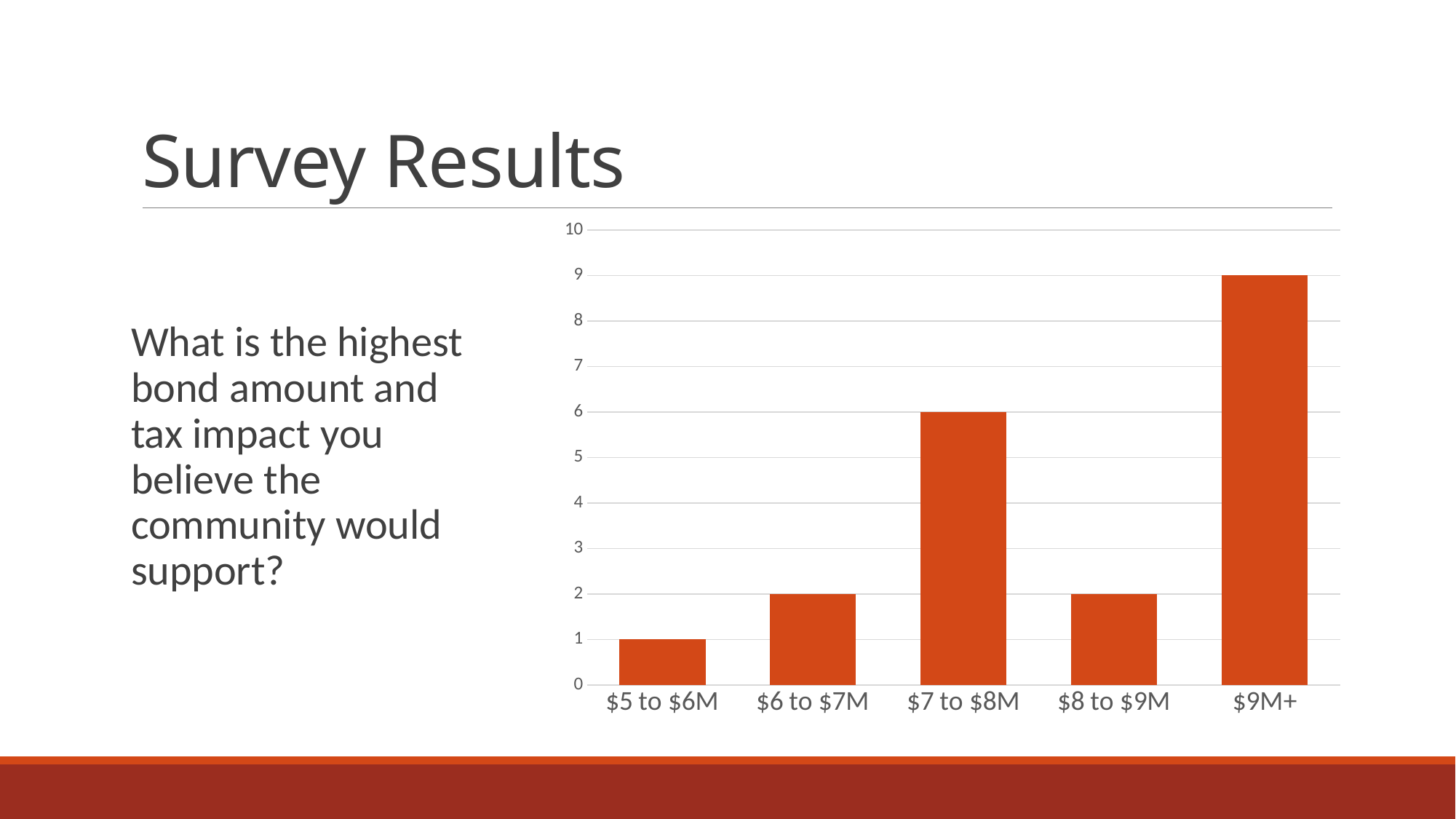
What is the difference between the values for $9M+ and $7 to $8M? 3 Is the value for $9M+ greater or less than 8? greater What is the maximum value shown on the vertical axis of the chart? 10 What is the value for $9M+? 9 What is the value for $7 to $8M? 6 Which category has the lowest value? $5 to $6M Which category has the highest value? $9M+ What is the value for $8 to $9M? 2 What is the value for $5 to $6M? 1 What type of chart is shown on the slide? bar chart How many categories are shown on the x axis of the chart? 5 Which is larger, the value for $6 to $7M or the value for $7 to $8M? $7 to $8M